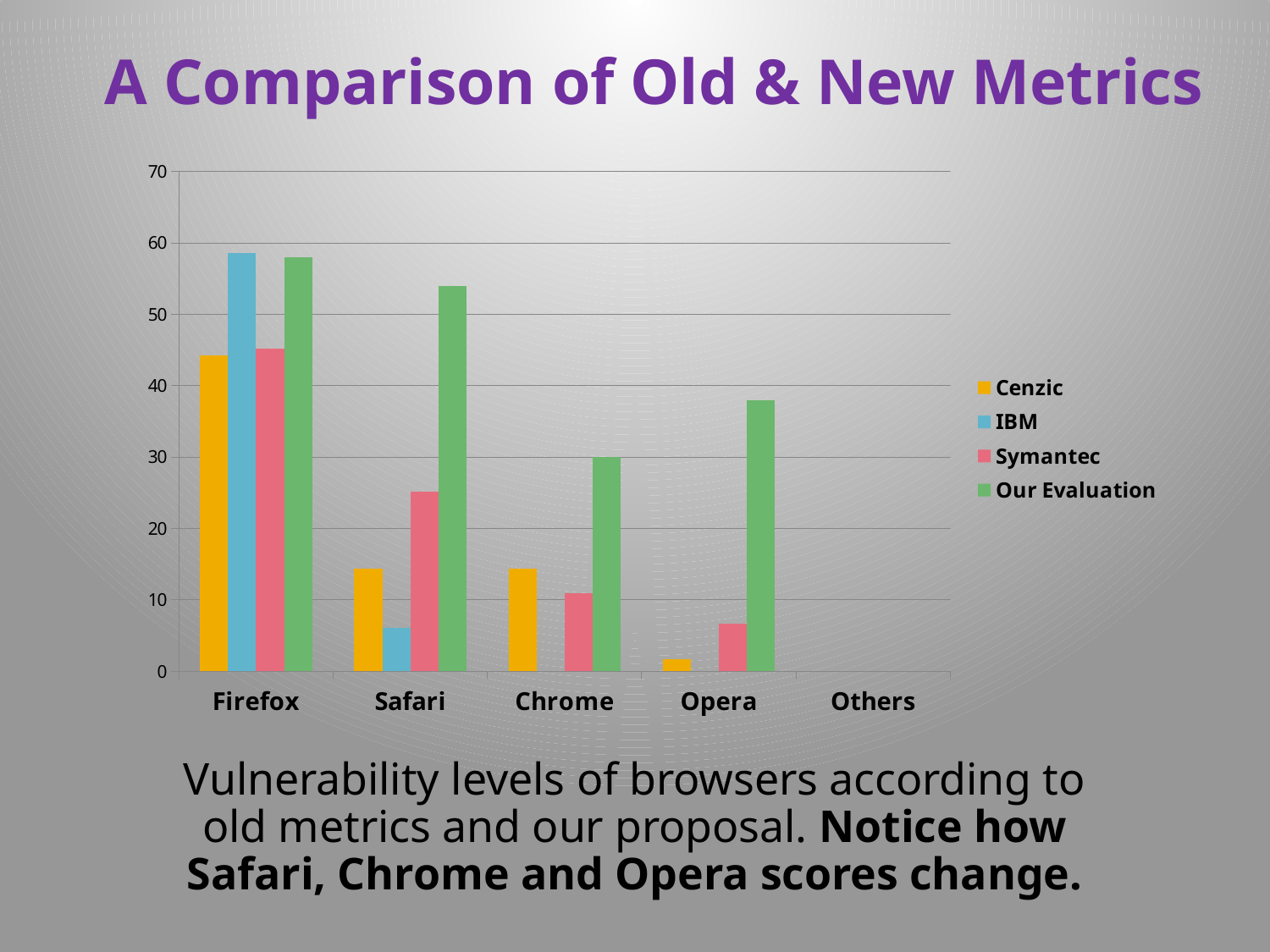
Is the Our Evaluation value for Opera greater or less than 30? greater How many series does the legend list? 4 Is the Cenzic value for Firefox greater or less than 40? greater How many browser categories are shown on the x axis? 5 Which browser has the highest Our Evaluation value? Firefox Is the Symantec value for Chrome greater or less than 20? less Which series is shown in green in the legend? Our Evaluation What kind of chart is shown on the slide? bar chart For Safari, which is larger: the Symantec value or the Our Evaluation value? Our Evaluation For Chrome, which is larger: the Cenzic value or the Our Evaluation value? Our Evaluation Which browser has the lowest Cenzic value among Firefox, Safari, Chrome and Opera? Opera